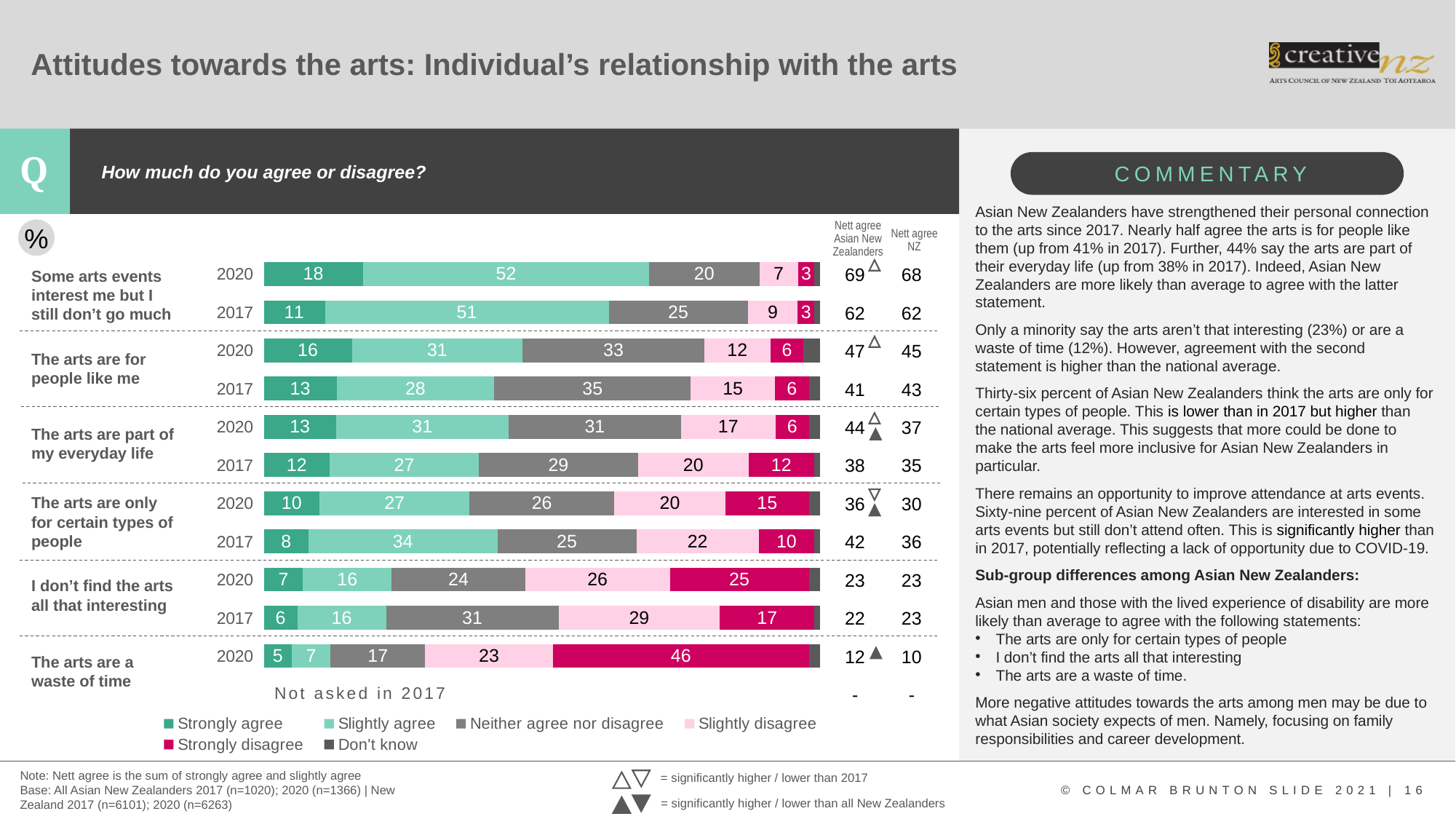
How many statements are shown in the chart? 6 How many series does the chart legend list? 6 What is the 'Neither agree nor disagree' value for 'The arts are for people like me' in 2017? 35 What is the 'Slightly agree' value for 'The arts are only for certain types of people' in 2017? 34 Which statement has the highest 'Slightly agree' value in 2020? Some arts events interest me but I still don't go much What type of chart is shown on the slide? Stacked bar chart What is the 'Strongly disagree' value for 'The arts are a waste of time' in 2020? 46 What is the Nett agree figure for Asian New Zealanders for 'The arts are part of my everyday life' in 2020? 44 Which is larger: the 'Slightly disagree' value for 'I don't find the arts all that interesting' in 2020 or in 2017? 2017 What is the 'Strongly agree' value for 'Some arts events interest me but I still don't go much' in 2020? 18 By how much did the 'Strongly disagree' value for 'The arts are part of my everyday life' change from 2017 to 2020? 6 Which statement was not asked in 2017? The arts are a waste of time